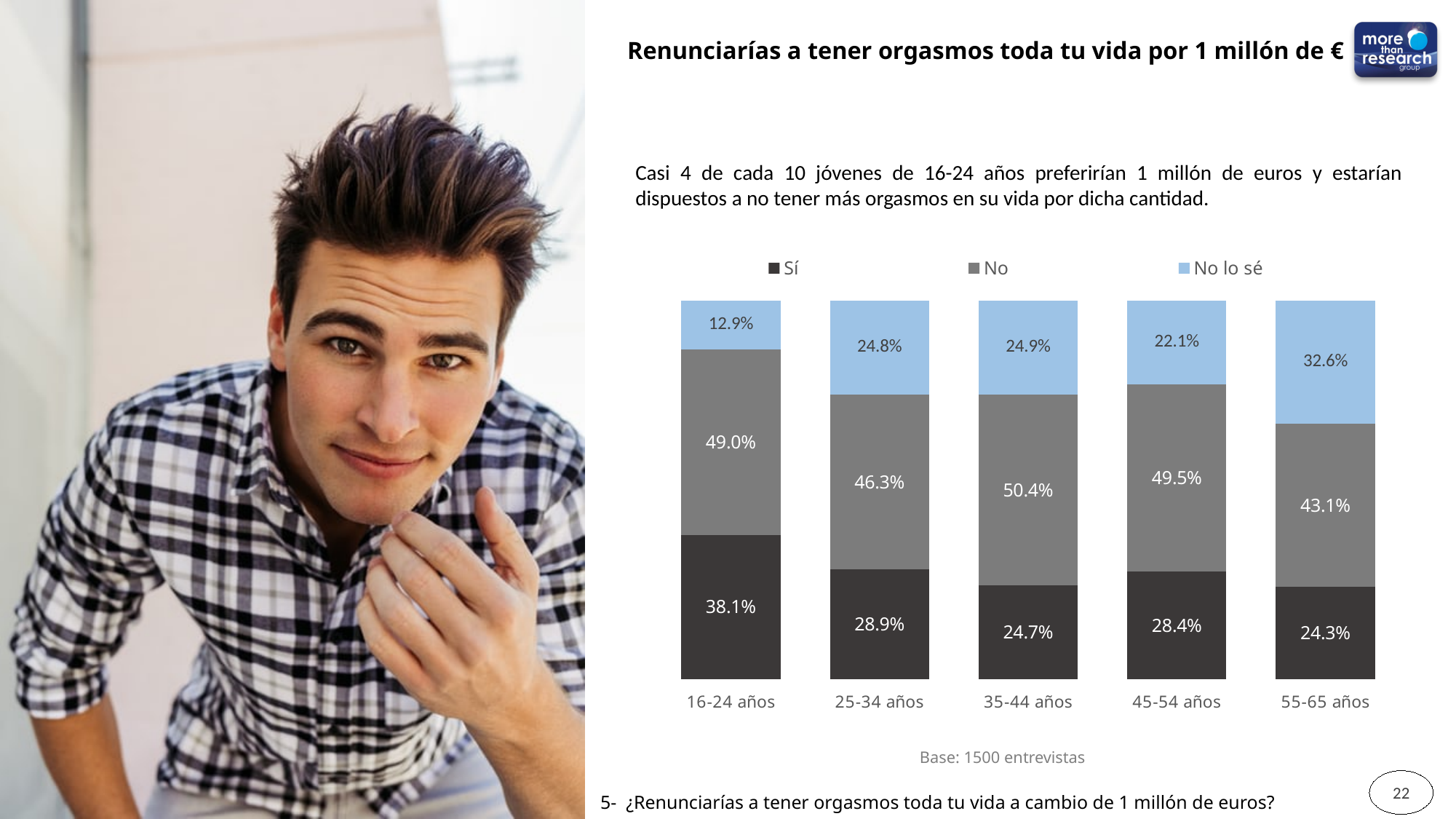
How many age groups are shown on the x axis? 5 What is the difference between the "Sí" values for 16-24 años and 25-34 años? 9.2% Which age group has the lowest "No lo sé" percentage? 16-24 años What kind of chart is shown on the slide? Stacked bar chart What is the "No lo sé" value for 55-65 años? 32.6% How many series does the legend list? 3 What percentage of 16-24 años answered "Sí"? 38.1% What is the "No" value for 35-44 años? 50.4% Which age group has the lowest "No" percentage? 55-65 años Which age group has the highest "Sí" percentage? 16-24 años What is the base (number of interviews) stated below the chart? 1500 entrevistas Which is larger: the "No lo sé" value for 25-34 años or for 45-54 años? 25-34 años